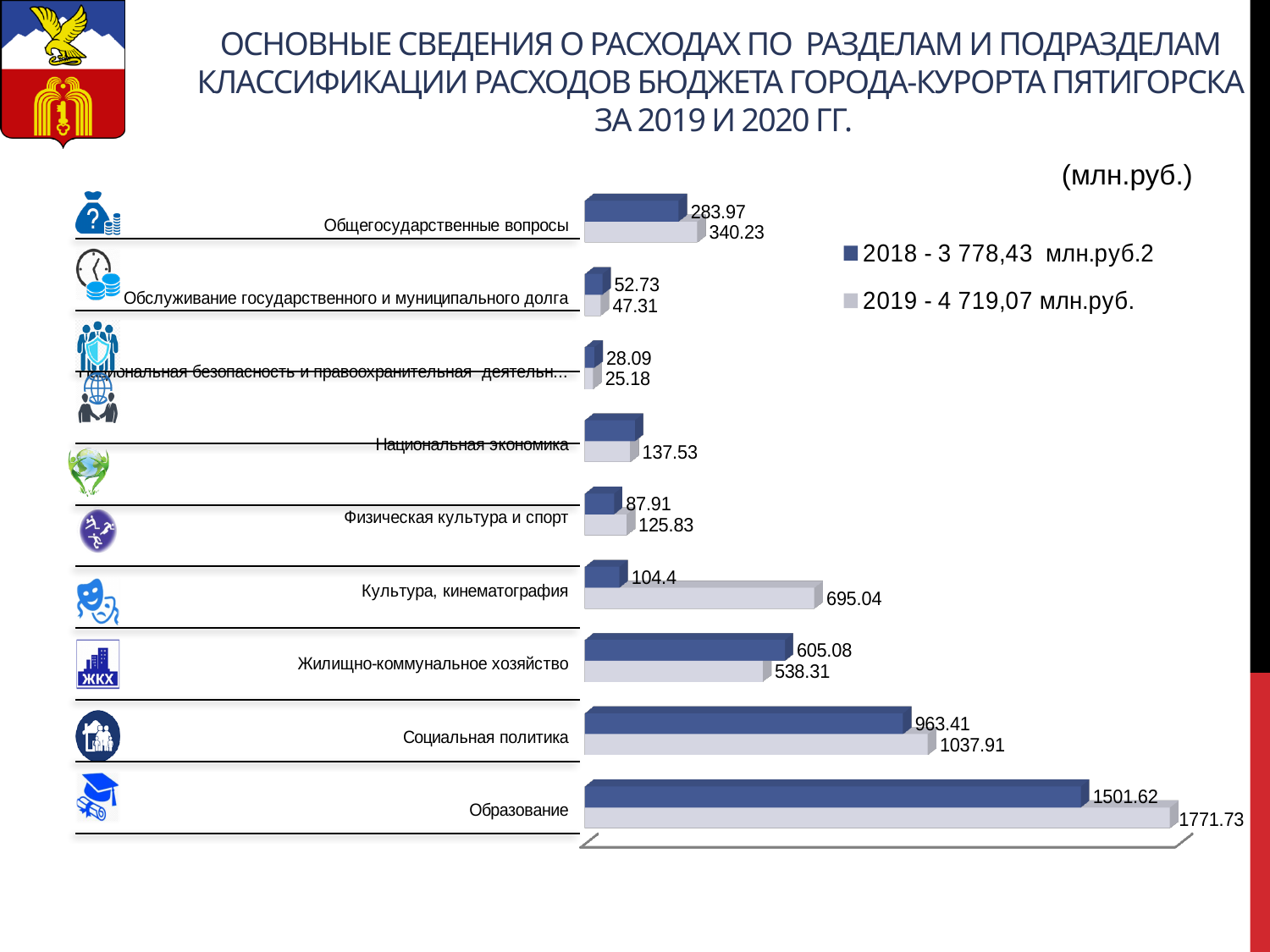
Which category has the lowest value in the 2018 series? Национальная безопасность и правоохранительная деятельность How many series does the legend list? 2 What unit of measurement is indicated on the slide for the chart values? млн.руб. Which is larger for Жилищно-коммунальное хозяйство: the 2018 value or the 2019 value? 2018 Which category has the highest value in the 2019 series? Образование What is the difference between the 2019 and 2018 values for Образование? 270.11 How many categories are shown in the chart? 9 What is the value for Образование in the 2019 series? 1771.73 What kind of chart is shown on the slide? bar chart What is the value for Культура, кинематография in the 2019 series? 695.04 What is the value for Социальная политика in the 2018 series? 963.41 What is the value for Жилищно-коммунальное хозяйство in the 2018 series? 605.08